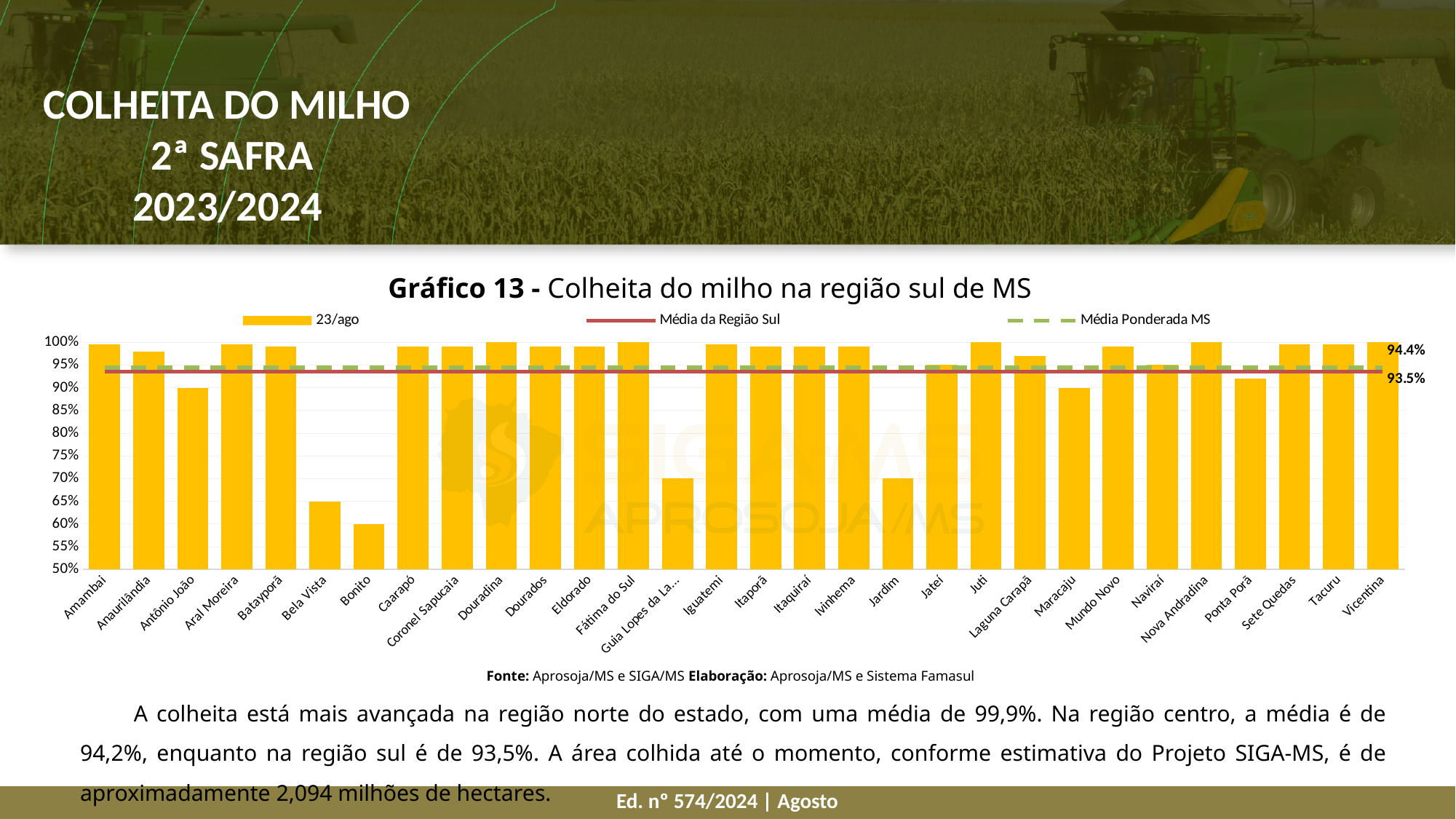
In Gráfico 13, what is the difference between Média Ponderada MS (94.4%) and Média da Região Sul (93.5%)? 0.9% What is the title of the chart on the slide? Gráfico 13 - Colheita do milho na região sul de MS In Gráfico 13, is the value for Ponta Porã greater or less than 90%? greater How many series does the legend of Gráfico 13 list? 3 What is the value of the Média Ponderada MS line in Gráfico 13? 94.4% In Gráfico 13, is the value for Bonito greater or less than 65%? less Which municipality has the lowest bar in Gráfico 13? Bonito What type of chart is Gráfico 13? Bar chart In Gráfico 13, which is higher: Média Ponderada MS or Média da Região Sul? Média Ponderada MS How many municipalities are shown on the x axis of Gráfico 13? 30 In Gráfico 13, which has the larger bar: Bela Vista or Bonito? Bela Vista What is the value of the Média da Região Sul line in Gráfico 13? 93.5%